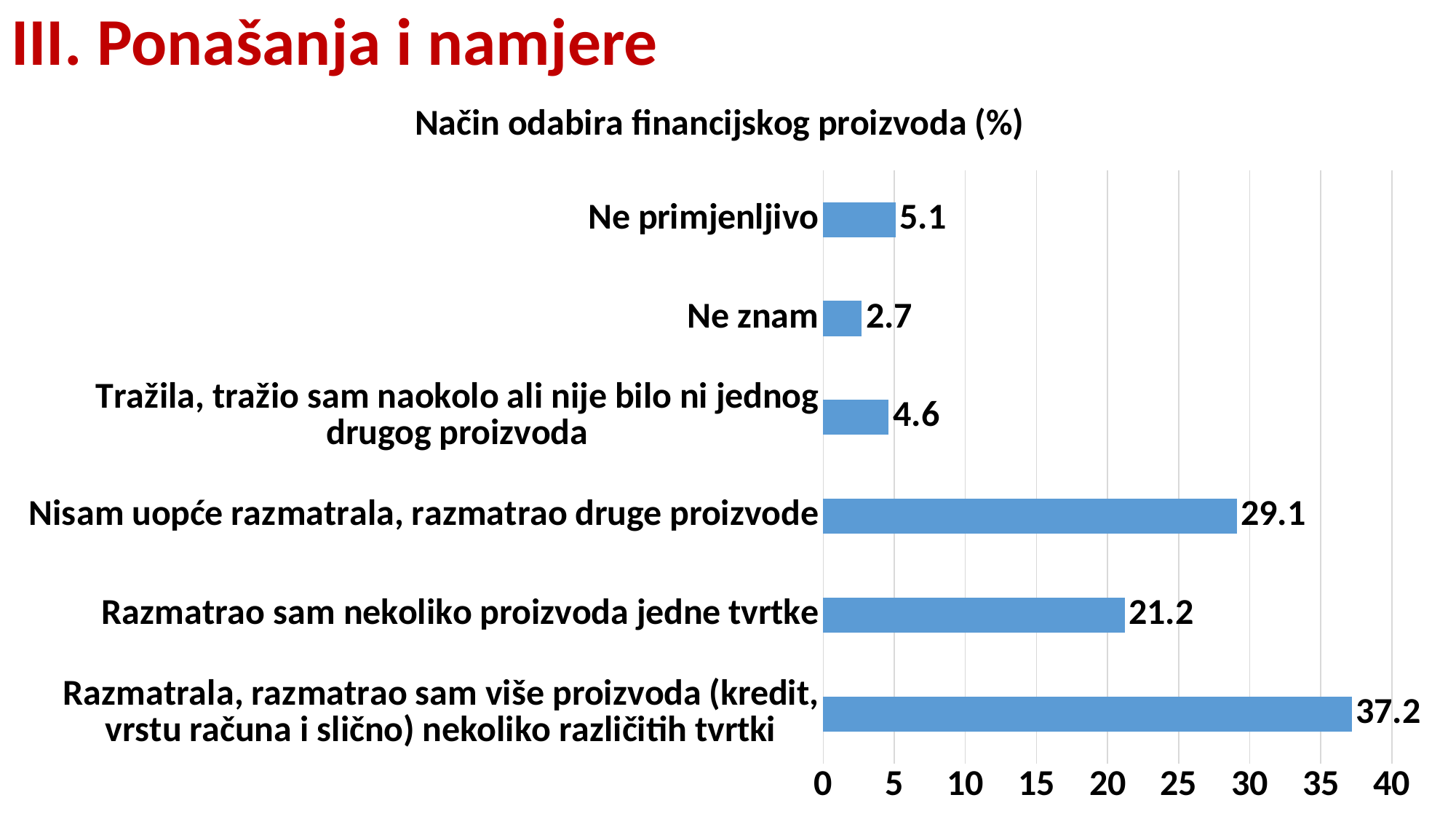
What is the difference between the values for "Ne primjenljivo" and "Ne znam"? 2.4 What is the difference between the values for "Razmatrala, razmatrao sam više proizvoda (kredit, vrstu računa i slično) nekoliko različitih tvrtki" and "Razmatrao sam nekoliko proizvoda jedne tvrtke"? 16 Which category has the lowest value? Ne znam What is the value for "Nisam uopće razmatrala, razmatrao druge proizvode"? 29.1 How many categories are shown in the chart? 6 What is the value for "Ne primjenljivo"? 5.1 What kind of chart is shown on the slide? Bar chart Is the value for "Nisam uopće razmatrala, razmatrao druge proizvode" greater or less than 25? greater What is the value for "Razmatrao sam nekoliko proizvoda jedne tvrtke"? 21.2 Which category has the highest value? Razmatrala, razmatrao sam više proizvoda (kredit, vrstu računa i slično) nekoliko različitih tvrtki What is the title of the chart? Način odabira financijskog proizvoda (%) Which is larger: the value for "Ne primjenljivo" or the value for "Tražila, tražio sam naokolo ali nije bilo ni jednog drugog proizvoda"? Ne primjenljivo